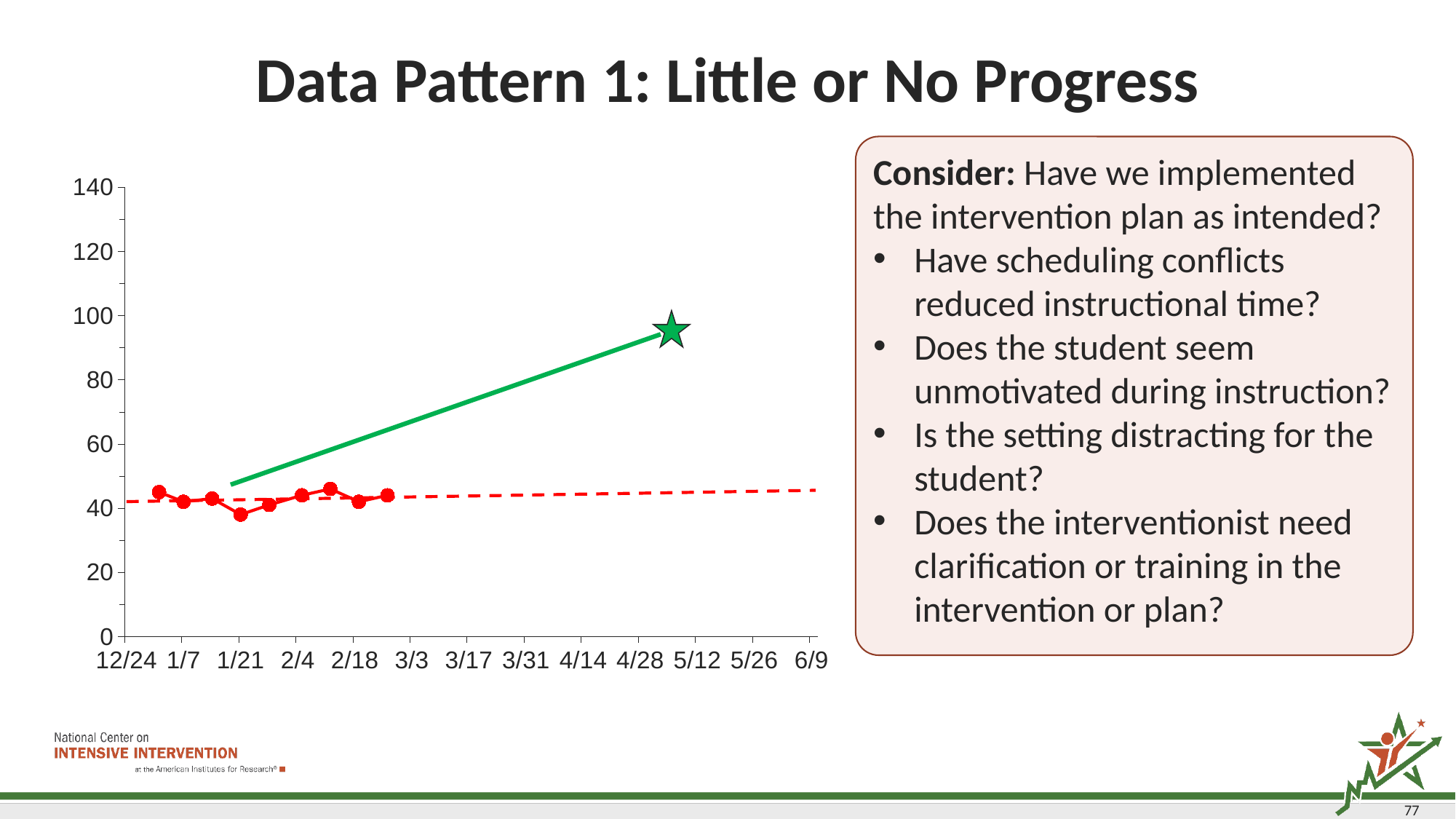
Do the red data points show a clear rise, a clear fall, or stay roughly flat over time? roughly flat What is the highest value shown on the y axis? 140 How many red data points are plotted on the chart? 9 Is the value of the first red data point (near 12/24) greater or less than 20? greater What kind of chart is shown on the slide? line chart How many date labels are shown on the x axis? 13 Is the value of the green star at the end of the goal line greater or less than 80? greater What symbol marks the end of the green goal line? a star Is the value of the red data point at 1/21 greater or less than 40? less At which date does the red data series reach its lowest point? 1/21